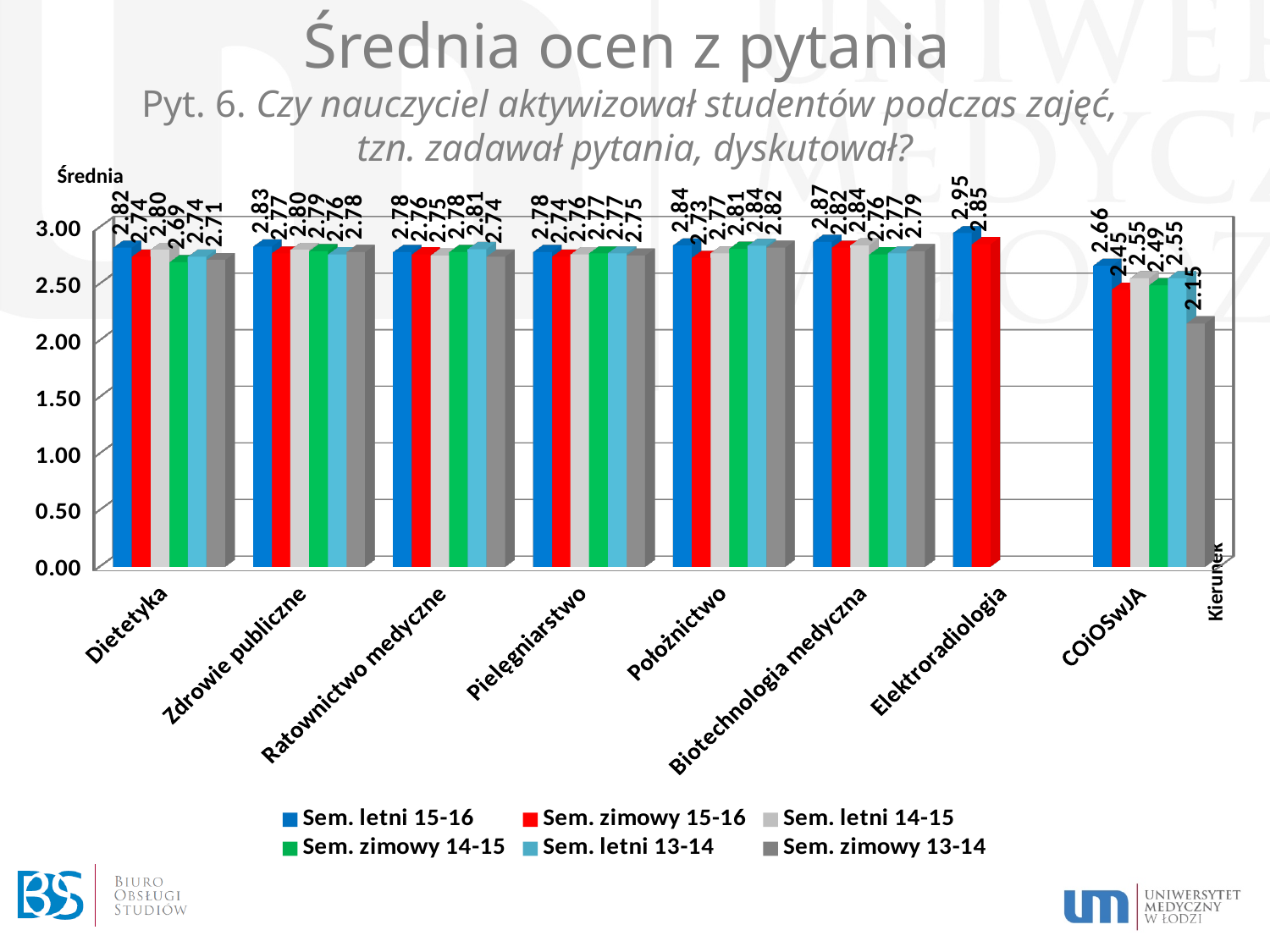
Which series is shown in red in the legend? Sem. zimowy 15-16 What is the value for COiOSwJA in the Sem. zimowy 13-14 series? 2.15 Which category has the highest value in the Sem. letni 15-16 series? Elektroradiologia What is the value for Dietetyka in the Sem. zimowy 14-15 series? 2.69 What kind of chart is shown on the slide? Bar chart How many categories are shown on the x axis? 8 What is the difference between the Sem. letni 15-16 and Sem. zimowy 15-16 values for COiOSwJA? 0.21 Which is larger for Położnictwo: the Sem. letni 15-16 value or the Sem. zimowy 15-16 value? Sem. letni 15-16 Which category has the lowest value in the Sem. zimowy 15-16 series? COiOSwJA How many series does the legend list? 6 What is the value for Elektroradiologia in the Sem. letni 15-16 series? 2.95 What is the value for Biotechnologia medyczna in the Sem. letni 14-15 series? 2.84